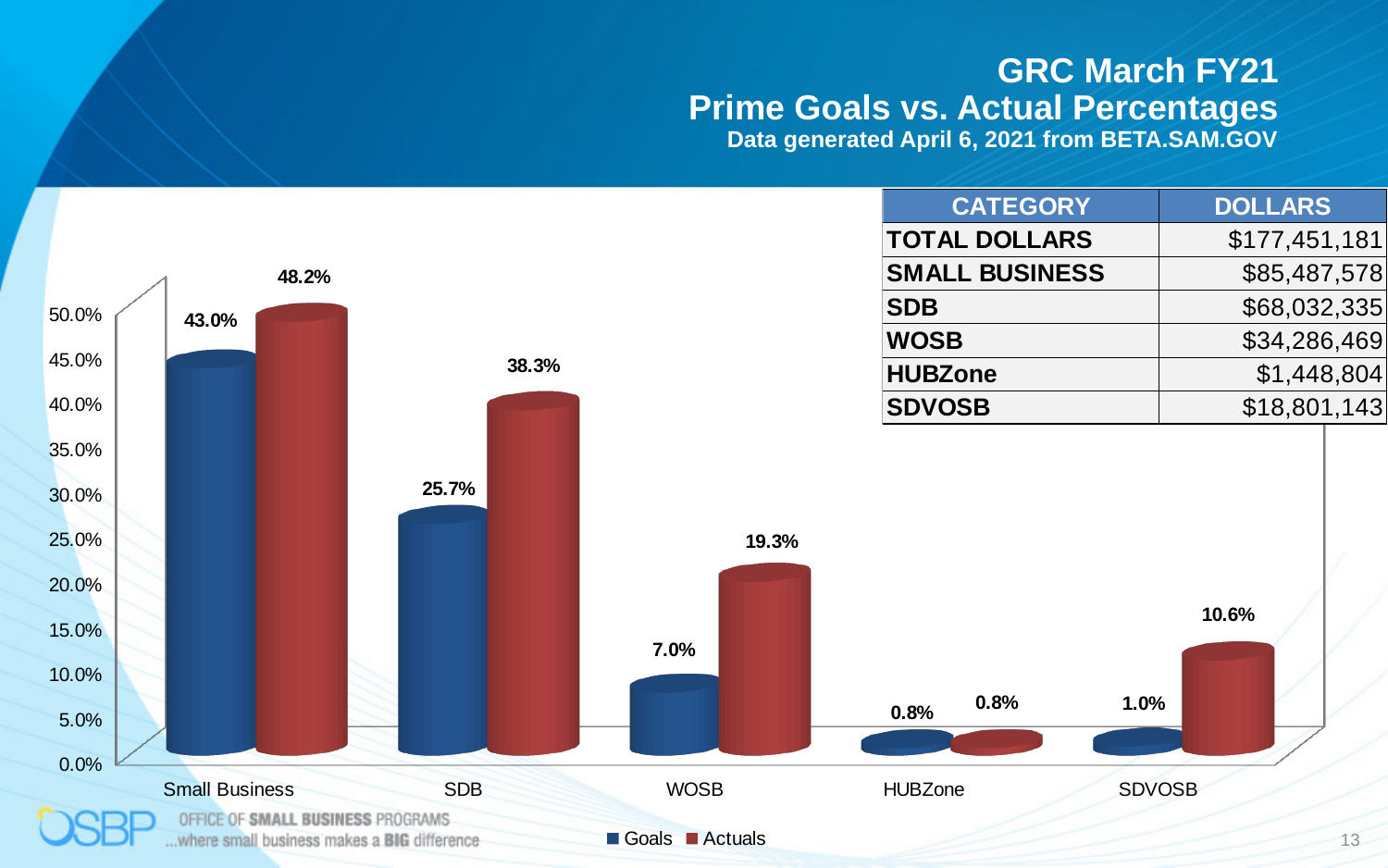
What is the Actuals value for Small Business? 48.2% Which is larger for WOSB, the Goals value or the Actuals value? Actuals What is the difference between the Actuals and Goals values for SDB? 12.6% Which category has the lowest Goals value? HUBZone What colour are the Actuals bars? Red How many categories are shown on the x axis? 5 What is the Goals value for SDB? 25.7% Which category has the highest Actuals value? Small Business What is the Actuals value for WOSB? 19.3% What kind of chart is shown on the slide? Bar chart How many series does the legend list? 2 What is the Goals value for SDVOSB? 1.0%